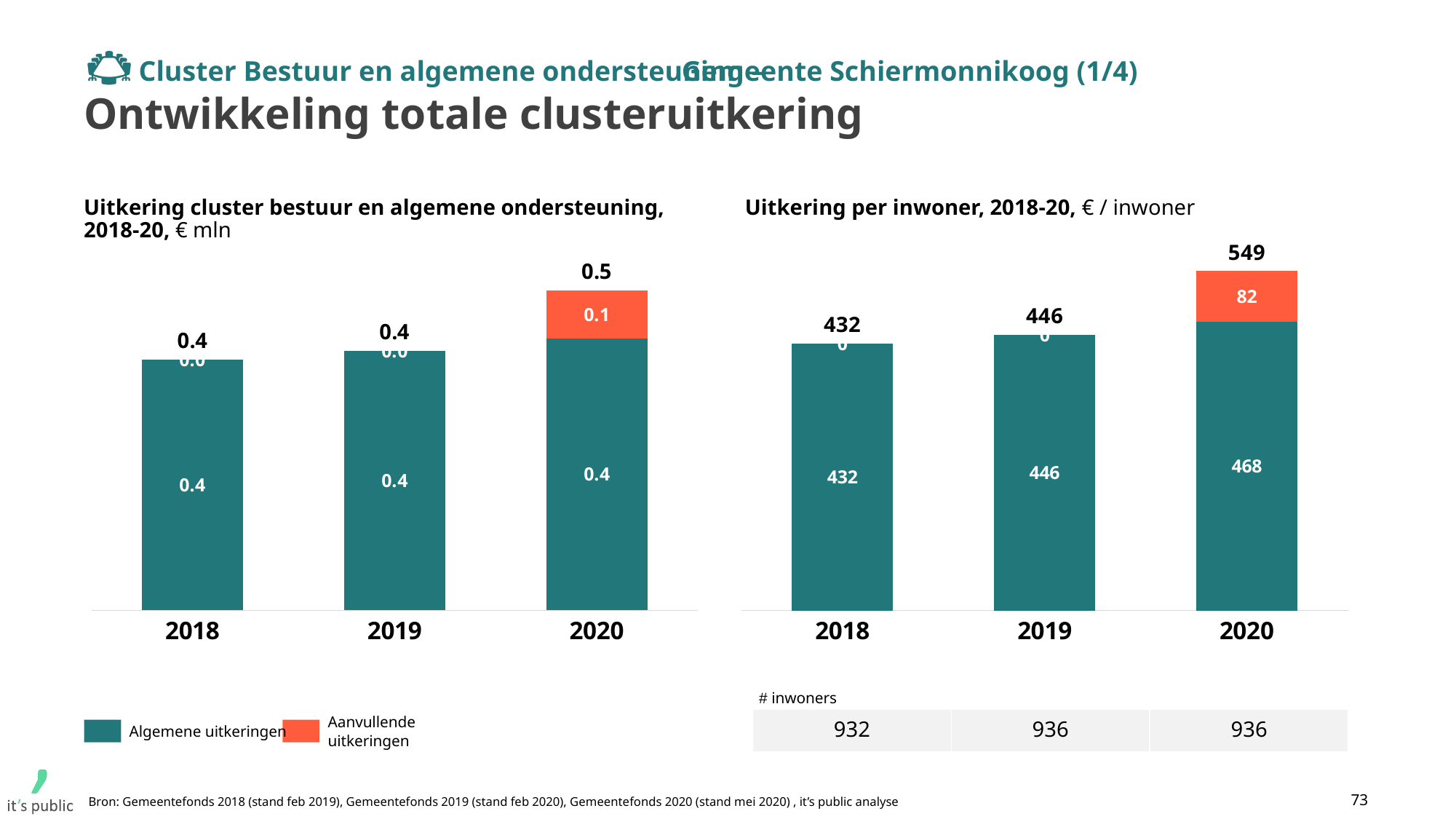
In the chart 'Uitkering per inwoner, 2018-20', which year has the lowest total uitkering per inwoner? 2018 In the chart 'Uitkering per inwoner, 2018-20', what is the value of Aanvullende uitkeringen for 2020? 82 In the chart 'Uitkering cluster bestuur en algemene ondersteuning, 2018-20', what is the total value shown above the 2020 bar? 0.5 How many series does the legend on the slide list? 2 In the chart 'Uitkering cluster bestuur en algemene ondersteuning, 2018-20', what is the value of Aanvullende uitkeringen for 2020? 0.1 How many years are shown on the x axis of the chart 'Uitkering per inwoner, 2018-20'? 3 In the chart 'Uitkering cluster bestuur en algemene ondersteuning, 2018-20', is the total for 2020 larger or smaller than the total for 2019? larger In the chart 'Uitkering per inwoner, 2018-20', what is the value of Algemene uitkeringen for 2020? 468 In the chart 'Uitkering per inwoner, 2018-20', what is the total shown above the 2020 bar? 549 What kind of chart is 'Uitkering per inwoner, 2018-20'? Stacked bar chart In the chart 'Uitkering per inwoner, 2018-20', what is the difference between the Algemene uitkeringen values for 2019 and 2018? 14 In the chart 'Uitkering per inwoner, 2018-20', which year has the highest total uitkering per inwoner? 2020